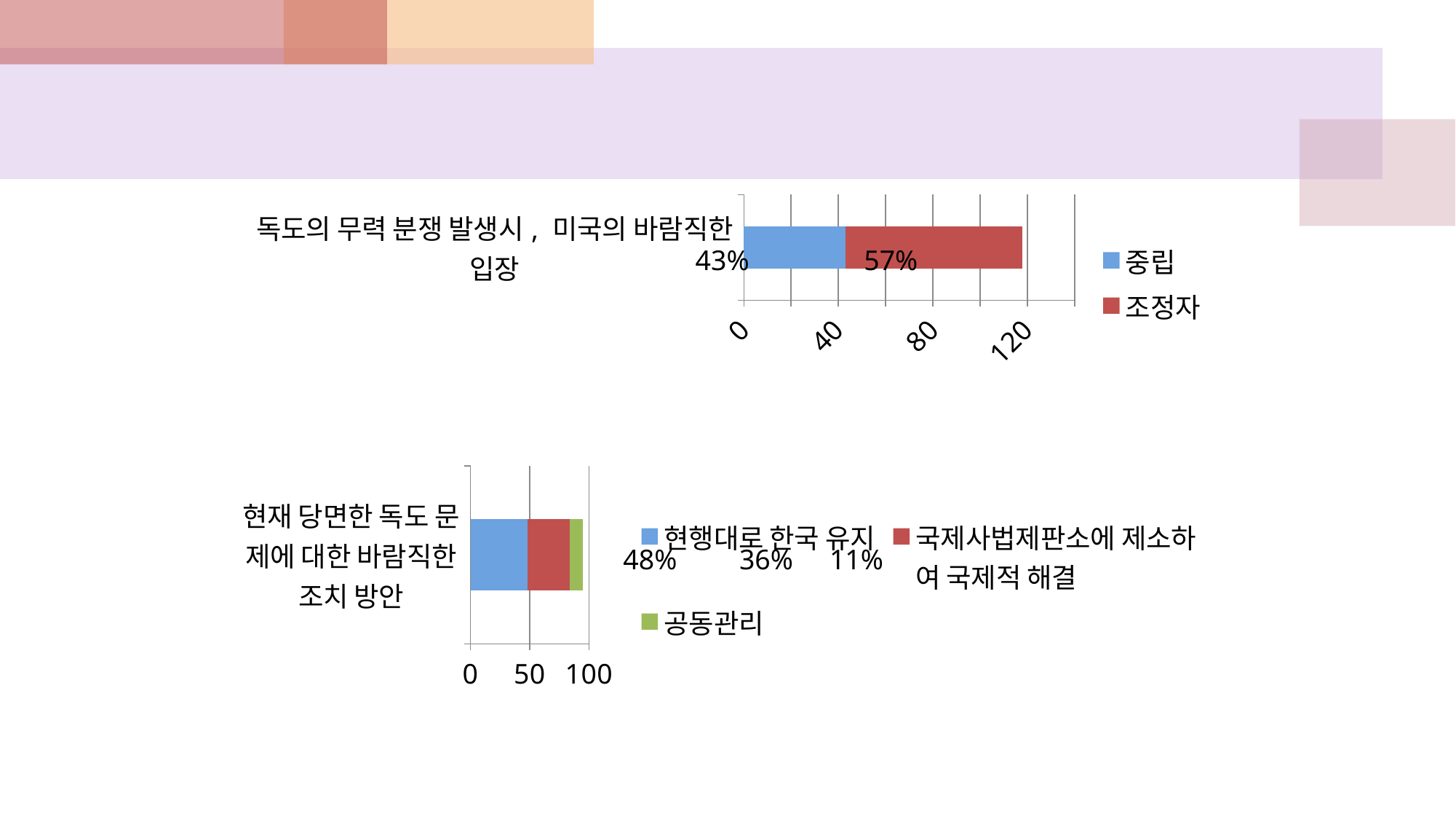
In the top chart, which series has the larger value, 중립 or 조정자? 조정자 What kind of chart is the top chart? Stacked bar chart In the top chart, what is the value for 조정자? 57% In the bottom chart, what is the difference between the values for 현행대로 한국 유지 and 국제사법제판소에 제소하여 국제적 해결? 12% In the bottom chart, which series has the lowest value? 공동관리 In the bottom chart, which series has the highest value? 현행대로 한국 유지 How many series does the legend of the bottom chart list? 3 In the bottom chart, what is the value for 공동관리? 11% In the top chart, what is the difference between the values for 조정자 and 중립? 14% In the top chart, what is the value for 중립? 43% In the bottom chart, what is the value for 현행대로 한국 유지? 48% How many series does the legend of the top chart list? 2